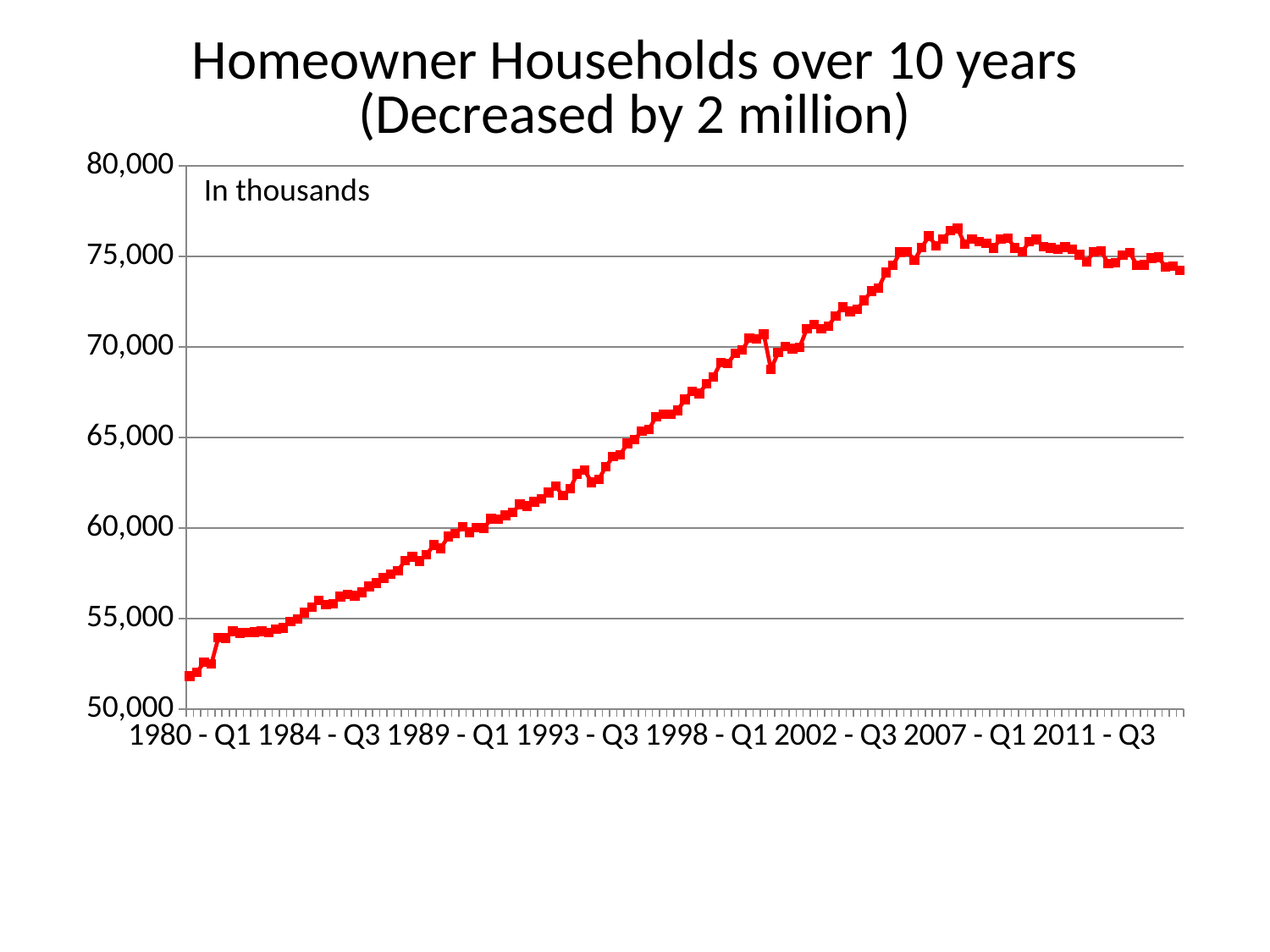
Is the value at 1998 - Q1 greater or less than 70,000? less Which is larger, the value at 1980 - Q1 or the value at 2011 - Q3? 2011 - Q3 Is the value at 1980 - Q1 greater or less than 55,000? less Is the value at 2002 - Q3 greater or less than 70,000? greater What kind of chart is shown on the slide? Line chart Does the line generally rise or fall from 1980 - Q1 to 2007 - Q1? Rise What is the title of the chart? Homeowner Households over 10 years (Decreased by 2 million) In what units are the values on the chart expressed, according to the note inside the plot area? In thousands